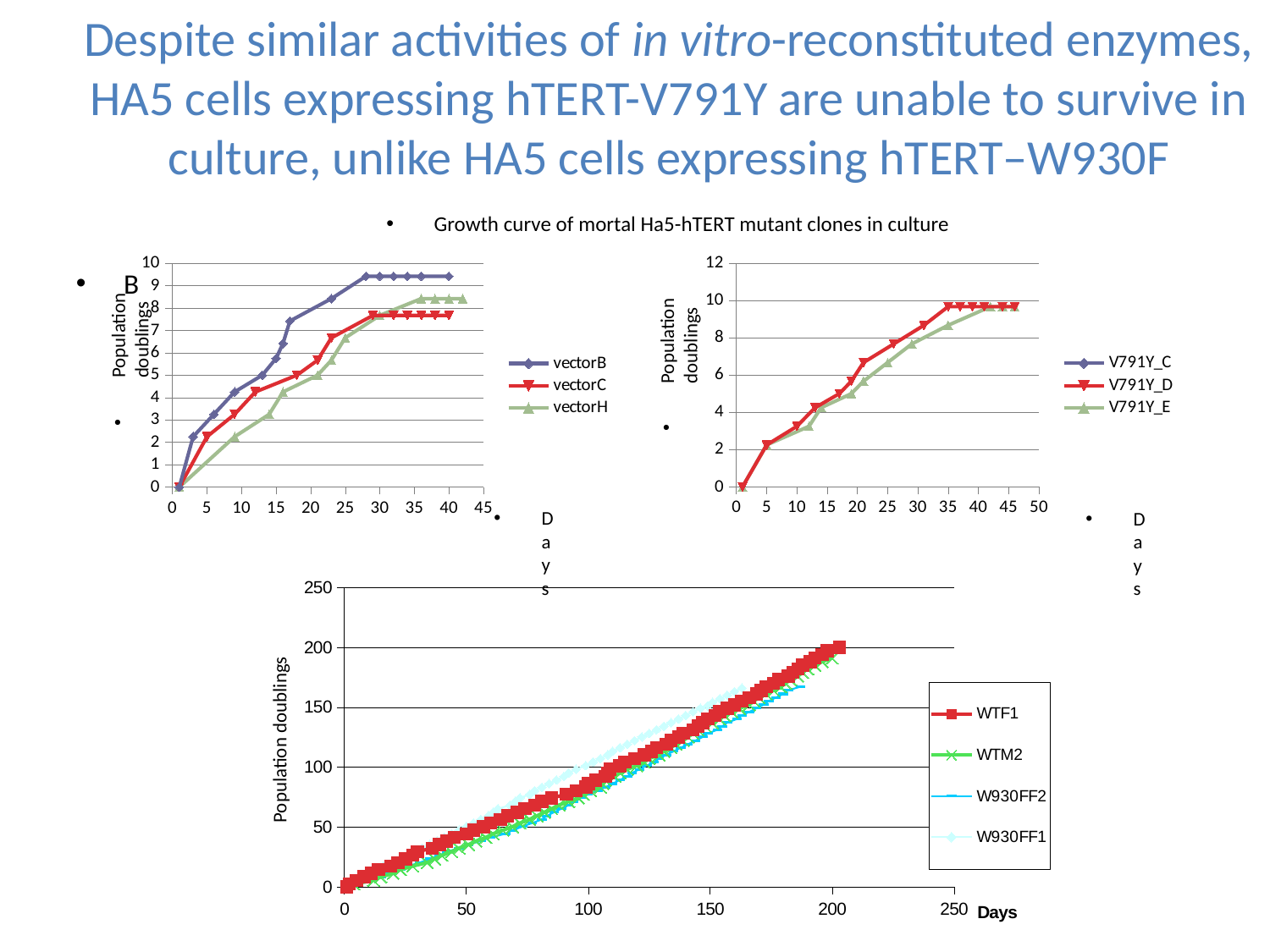
In the top-left chart, which series reaches the highest population doublings, vectorB or vectorC? vectorB How many series does the legend of the bottom chart (WTF1, WTM2, W930FF2, W930FF1) list? 4 What is the y-axis title of the bottom chart? Population doublings In the top-right chart, is the final plateau value for V791Y_D greater or less than 8? greater In the top-left chart, is the final plateau value for vectorC greater or less than 8? less What kind of chart is the top-left chart with vectorB, vectorC and vectorH? line chart In the top-left chart, do the population doublings rise or fall as days increase? rise In the bottom chart, is the value for WTF1 at day 200 greater or less than 150? greater How many series does the legend of the top-right chart (V791Y_C, V791Y_D, V791Y_E) list? 3 How many series does the legend of the top-left chart (vectorB, vectorC, vectorH) list? 3